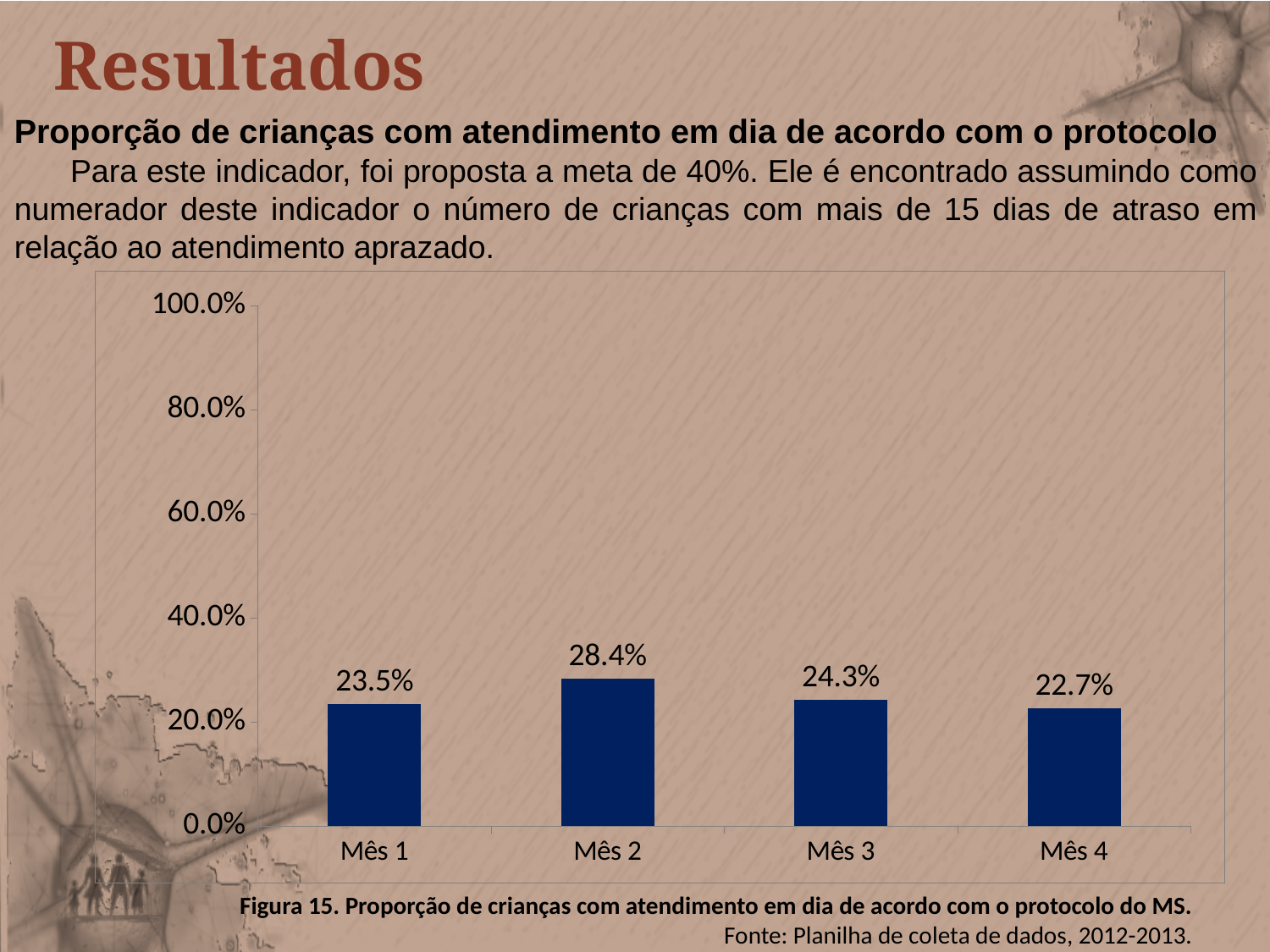
Is the value for Mês 2 greater or less than 40.0%? less What is the value for Mês 1? 23.5% What is the value for Mês 4? 22.7% Which is larger, the value for Mês 2 or the value for Mês 3? Mês 2 How many months are shown on the x axis? 4 What kind of chart is shown on the slide? bar chart What is the difference between the values for Mês 2 and Mês 4? 5.7% Which month has the lowest value? Mês 4 What is the difference between the values for Mês 3 and Mês 1? 0.8% What is the figure caption below the chart? Figura 15. Proporção de crianças com atendimento em dia de acordo com o protocolo do MS. Which month has the highest value? Mês 2 What is the value for Mês 2? 28.4%